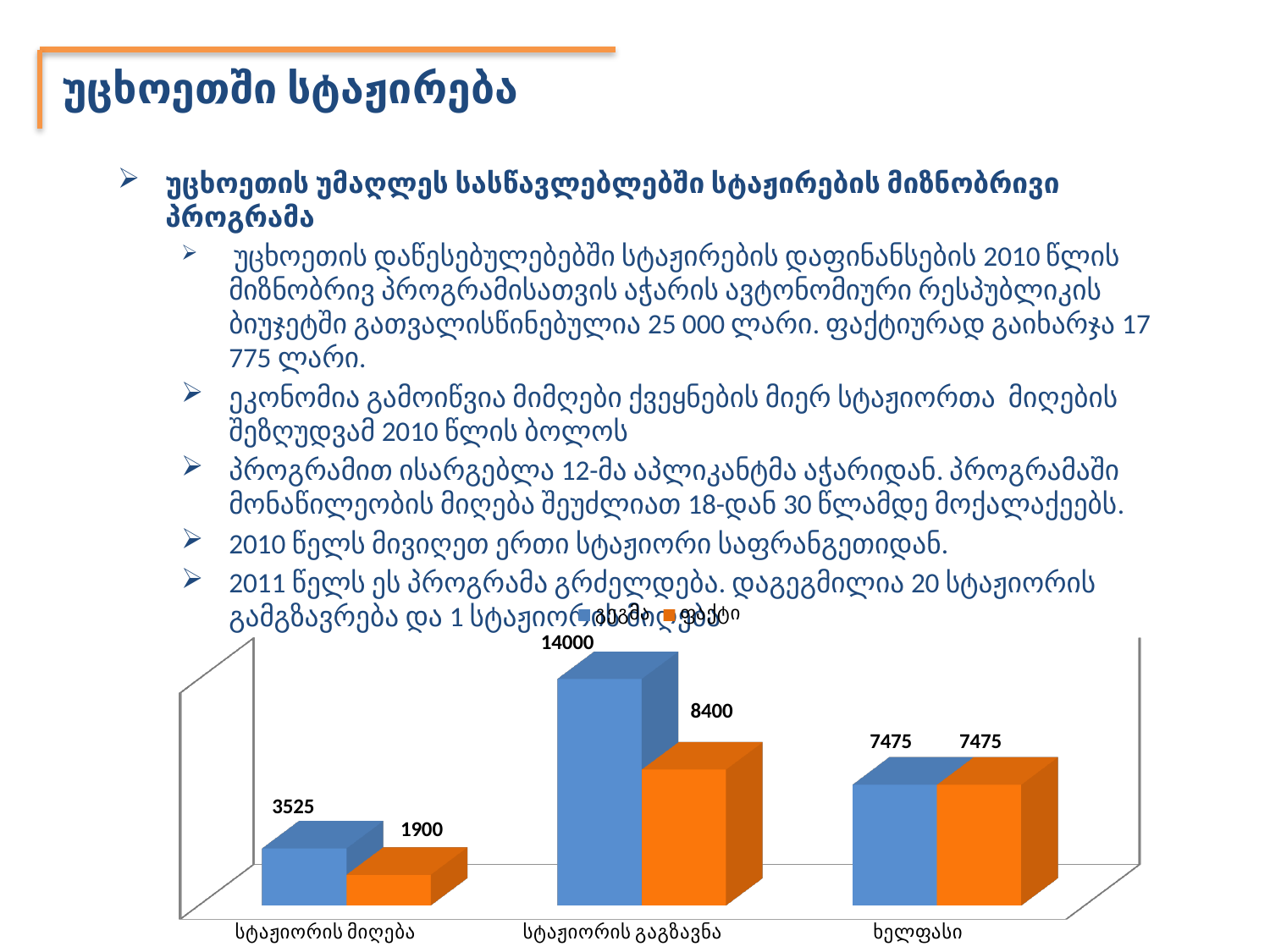
What kind of chart is shown on the slide? Bar chart What is the value of the orange bar for ხელფასი? 7475 Which category has the lowest orange bar? სტაჟიორის მიღება What is the value of the orange bar for სტაჟიორის გაგზავნა? 8400 Which category has the highest blue bar? სტაჟიორის გაგზავნა What is the value of the orange bar for სტაჟიორის მიღება? 1900 What is the value of the blue bar for სტაჟიორის გაგზავნა? 14000 How many categories are shown on the x axis of the chart? 3 Which is larger: the blue bar for სტაჟიორის გაგზავნა or the blue bar for ხელფასი? სტაჟიორის გაგზავნა What is the difference between the blue and orange bars for სტაჟიორის გაგზავნა? 5600 What is the value of the blue bar for სტაჟიორის მიღება? 3525 What is the difference between the blue and orange bars for სტაჟიორის მიღება? 1625